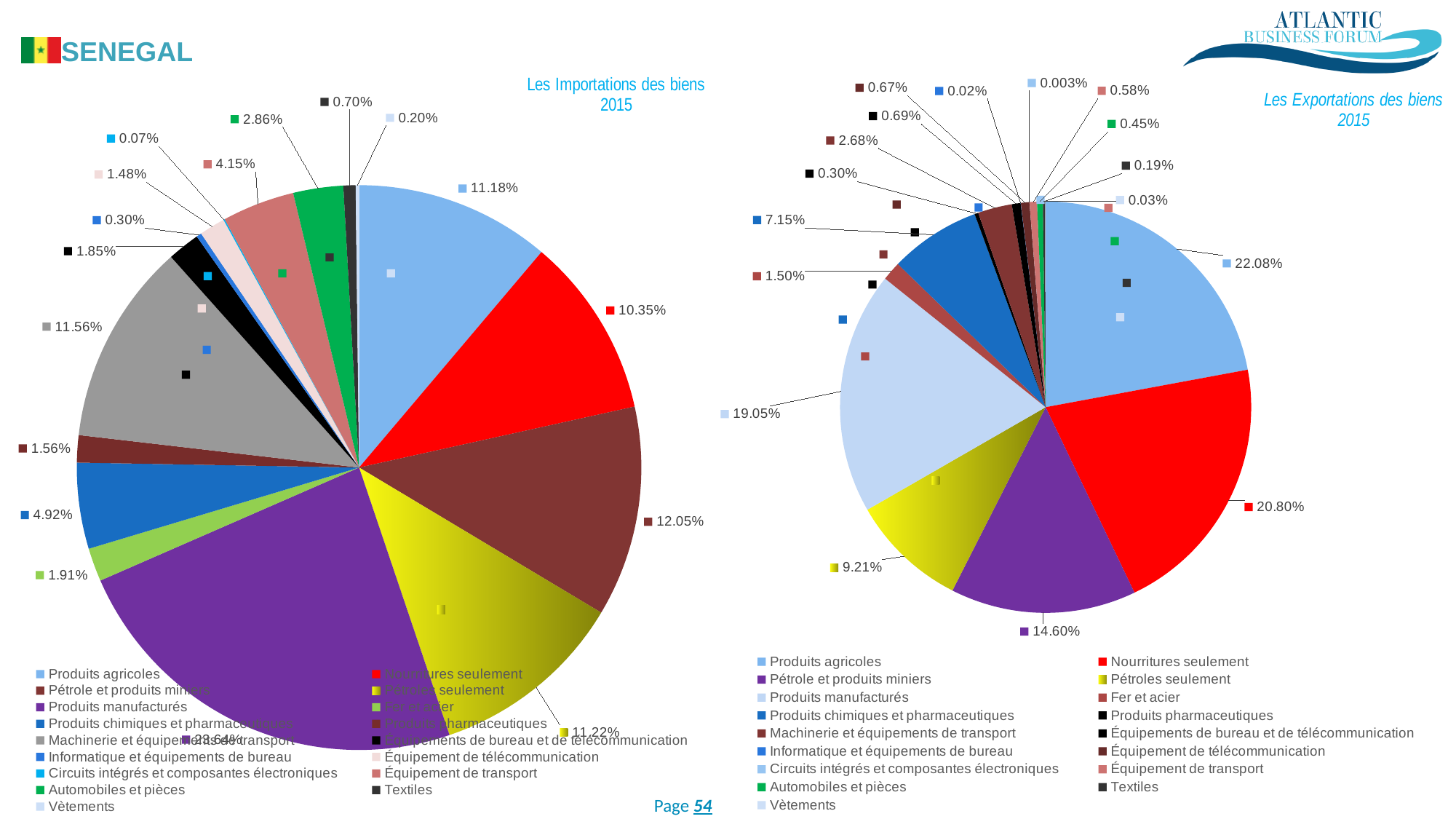
In the 'Les Importations des biens 2015' chart, what is the share for Pétrole et produits miniers? 12.05% What kind of chart is used for 'Les Importations des biens 2015'? Pie chart In the 'Les Exportations des biens 2015' chart, what is the share for Produits agricoles? 22.08% In the 'Les Exportations des biens 2015' chart, what is the difference between the shares of Produits agricoles and Nourritures seulement? 1.28% In the 'Les Exportations des biens 2015' chart, what is the share for Pétroles seulement? 9.21% How many categories does the legend of the 'Les Exportations des biens 2015' chart list? 17 In the 'Les Importations des biens 2015' chart, what is the share for Produits agricoles? 11.18% In the 'Les Exportations des biens 2015' chart, what is the share for Nourritures seulement? 20.80% In the 'Les Exportations des biens 2015' chart, which category has the largest slice? Produits agricoles In the 'Les Importations des biens 2015' chart, which category has the largest slice? Produits manufacturés In the 'Les Exportations des biens 2015' chart, which is larger: Pétrole et produits miniers or Produits manufacturés? Produits manufacturés In the 'Les Importations des biens 2015' chart, what is the share for Nourritures seulement? 10.35%